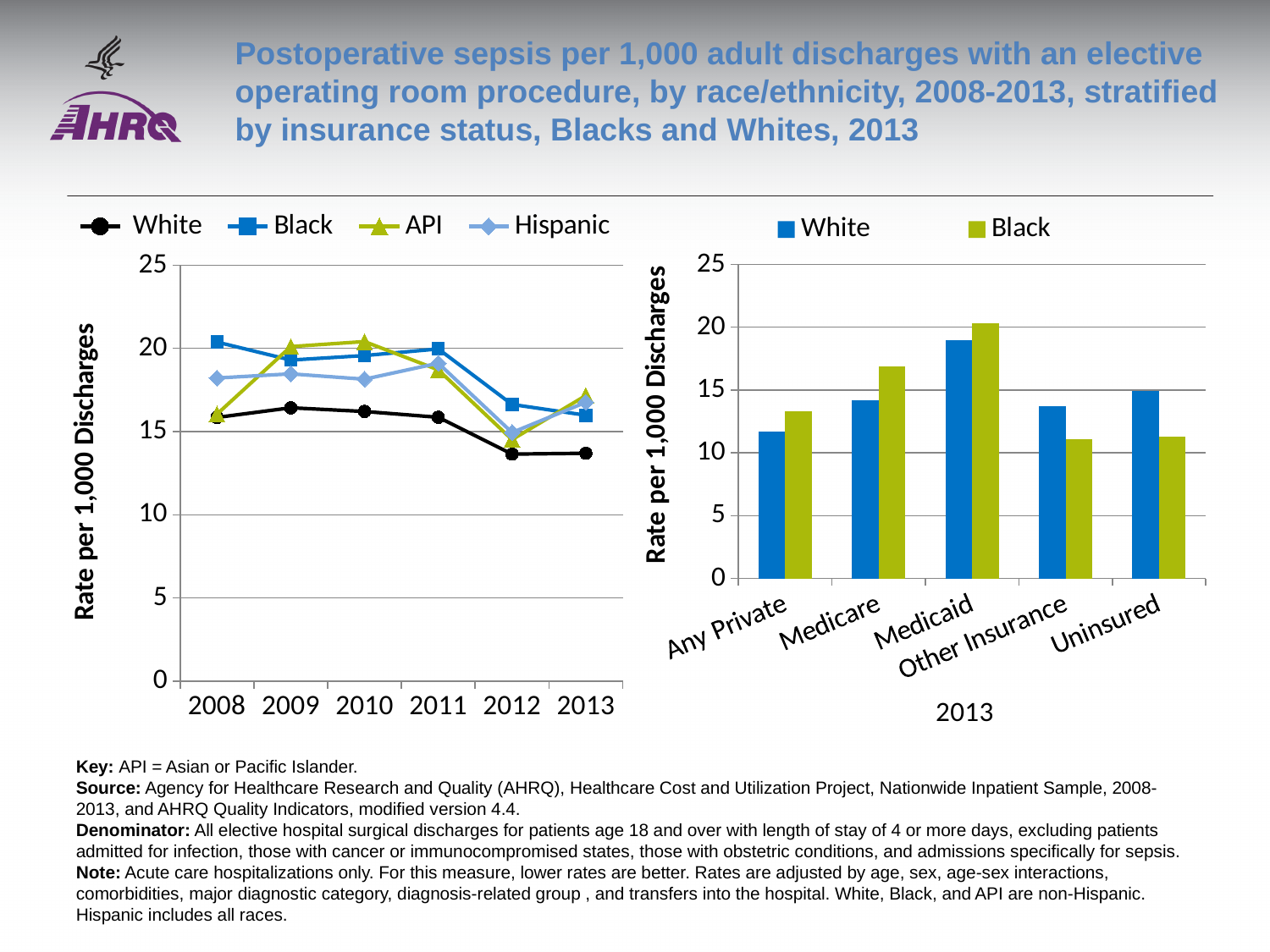
How many insurance status categories are shown on the right chart? 5 On the right chart (2013, by insurance status), which insurance category has the highest value for Black? Medicaid On the right chart (2013, by insurance status), in the Uninsured category, which is larger: White or Black? White How many years are shown on the x axis of the left chart? 6 On the right chart (2013, by insurance status), is the value for White in the Medicaid category greater or less than 15? greater On the right chart (2013, by insurance status), is the value for White in the Any Private category greater or less than 15? less On the left chart (2008-2013), which race/ethnicity group had the highest rate in 2008? Black What kind of chart is the chart on the right (White vs Black by insurance status, 2013)? bar chart On the left chart (2008-2013), does the White rate rise or fall from 2011 to 2013? fall What kind of chart is the chart on the left (rates by race/ethnicity, 2008-2013)? line chart How many series does the legend of the right chart (2013, by insurance status) list? 2 How many series does the legend of the left chart (2008-2013) list? 4